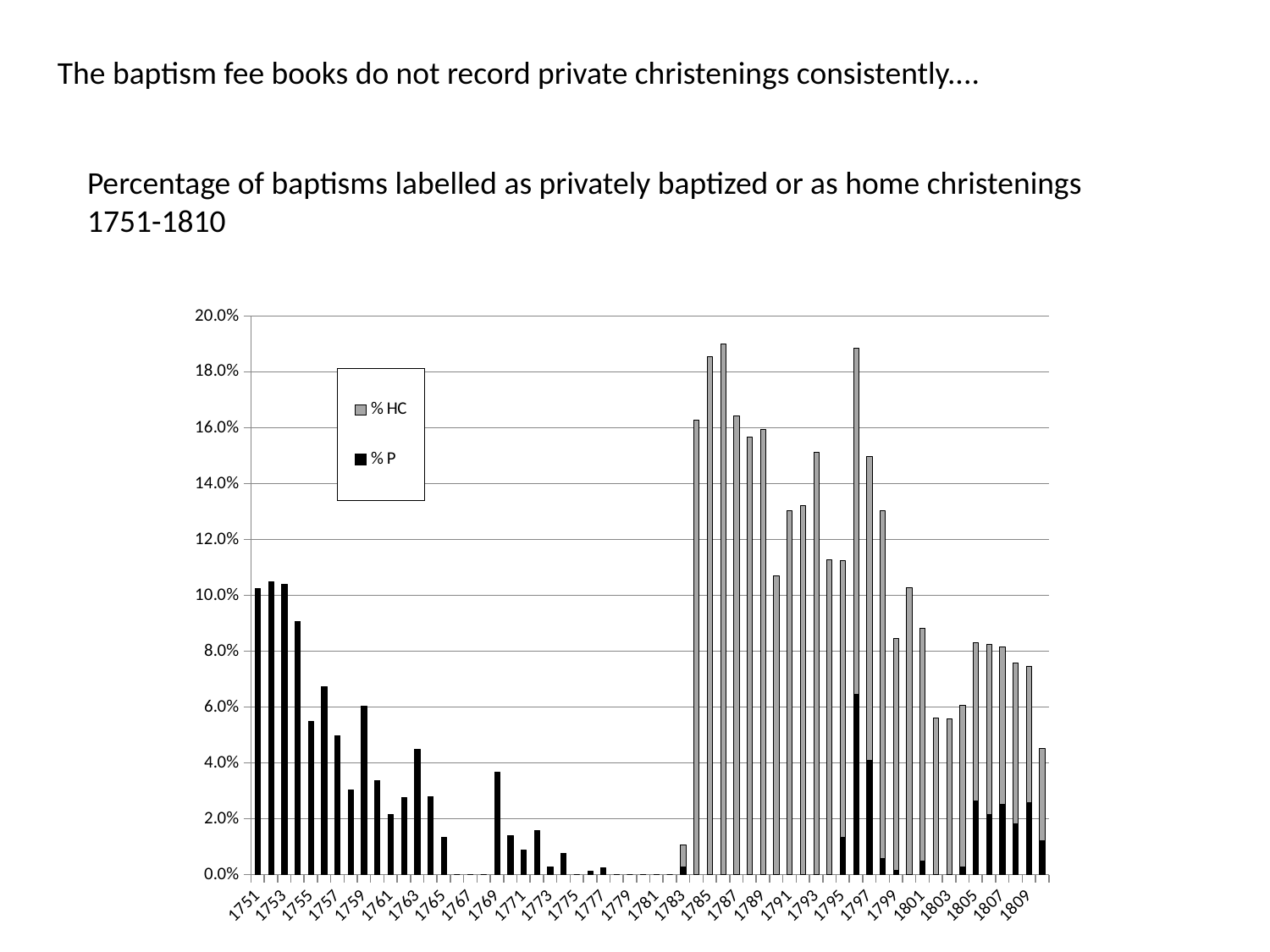
Which colour represents the % HC series in the chart? grey Is the % P value for 1763 greater or less than 4.0%? greater What kind of chart is shown on the slide? bar chart Is the total bar for 1791 greater or less than 10.0%? greater Is the total bar for 1809 greater or less than 8.0%? less What are the two series named in the chart's legend? % HC and % P How many series does the chart's legend list? 2 Do the % P values generally rise or fall from 1751 to 1765? fall Which year has the larger % P value, 1751 or 1755? 1751 Which year has the taller total bar, 1785 or 1791? 1785